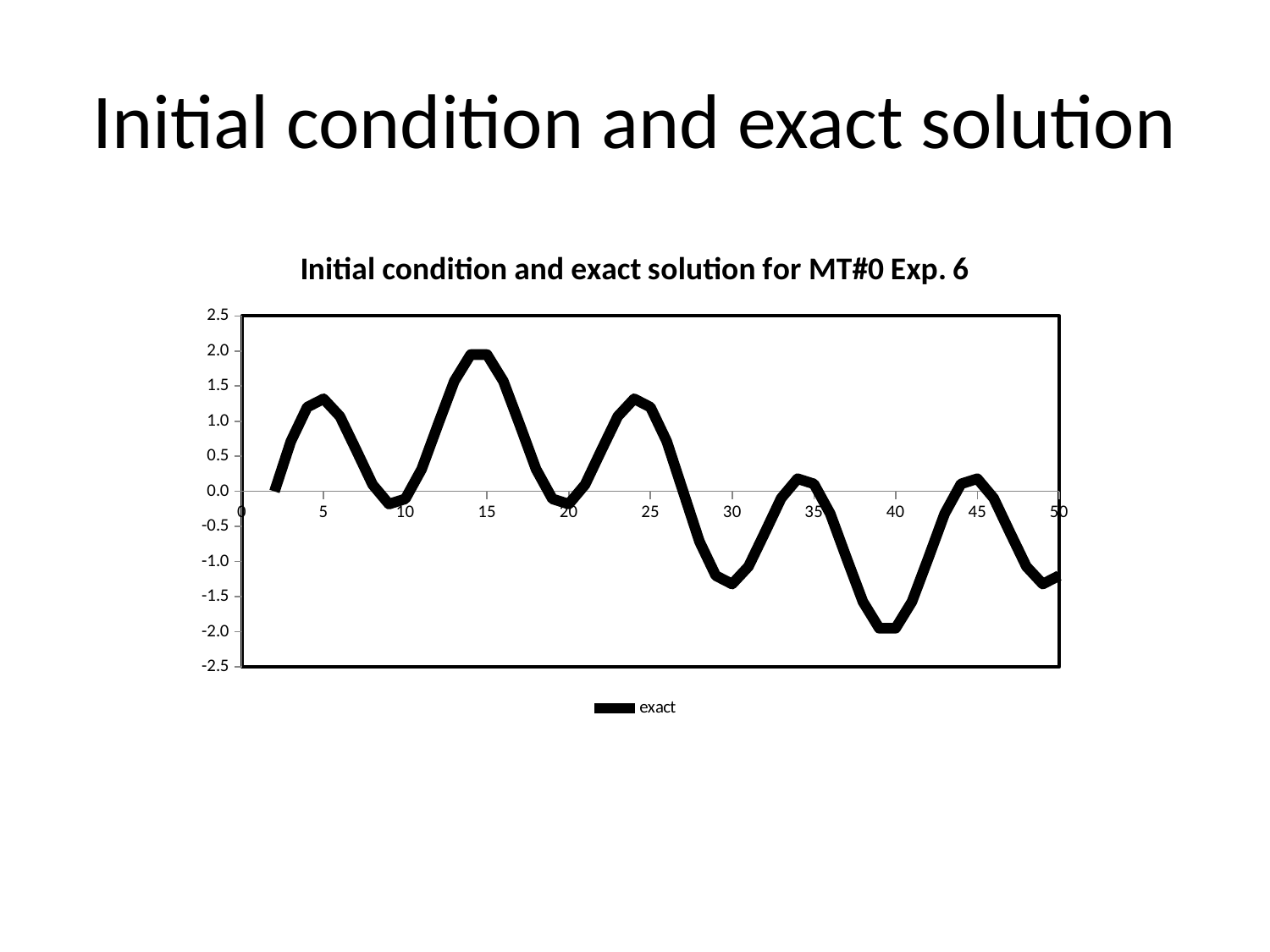
Is the value of the exact series at x = 15 greater or less than 1.5? greater Is the value of the exact series at x = 35 greater or less than 0.5? less Around which x-axis tick does the exact series reach its lowest trough? 40 How many series does the legend list? 1 What is the name of the series shown in the legend? exact Which is larger, the value of the exact series at x = 15 or at x = 5? x = 15 Around which x-axis tick does the exact series reach its highest peak? 15 Is the value of the exact series at x = 30 greater or less than -1.0? less What is the title of the chart? Initial condition and exact solution for MT#0 Exp. 6 What kind of chart is shown on the slide? line chart